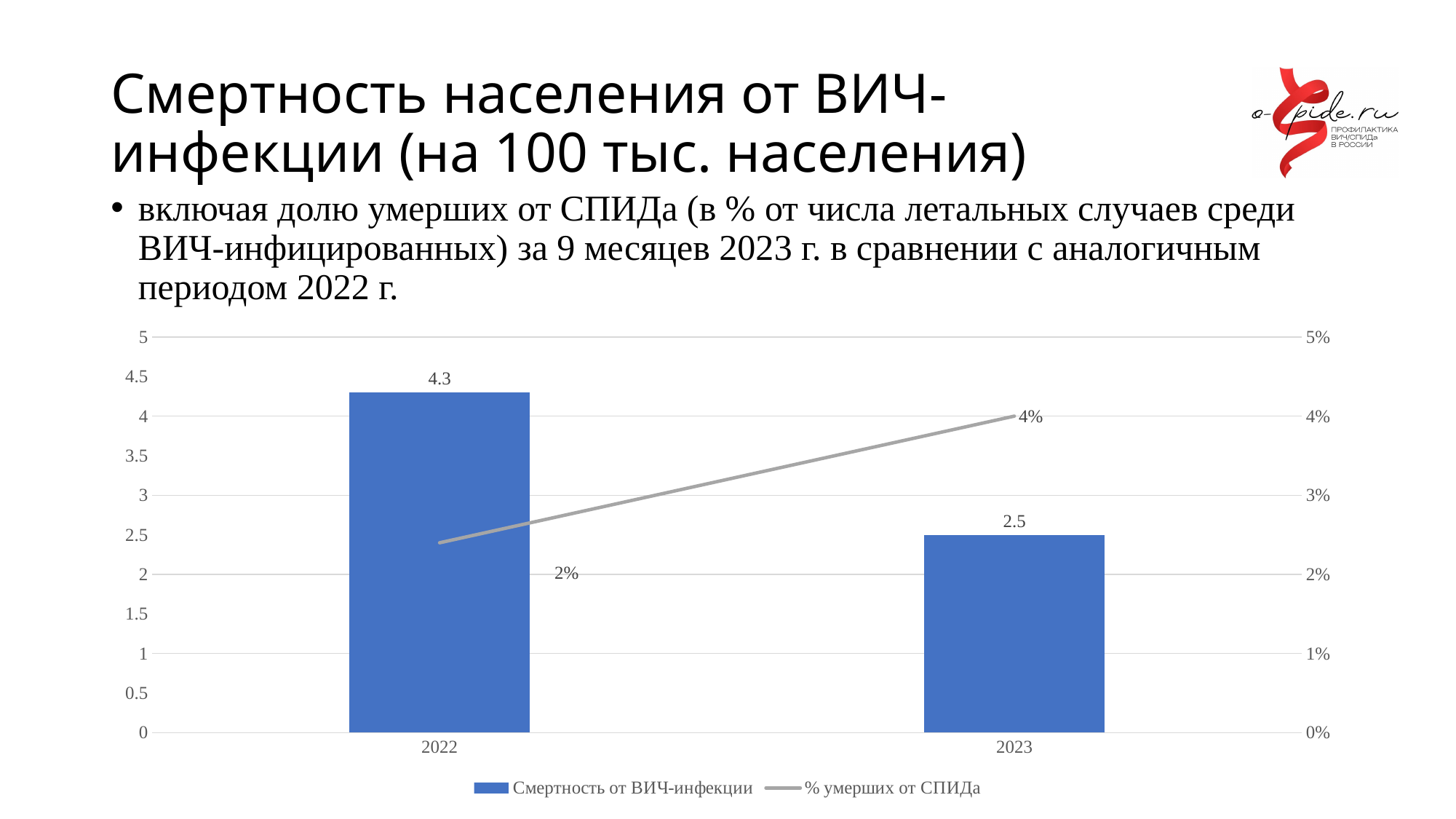
How many series does the legend list? 2 Does the Смертность от ВИЧ-инфекции series rise or fall from 2022 to 2023? fall What is the value of Смертность от ВИЧ-инфекции for 2023? 2.5 What is the value of % умерших от СПИДа for 2023? 4% What is the value of % умерших от СПИДа for 2022? 2% What is the value of Смертность от ВИЧ-инфекции for 2022? 4.3 How many years are shown on the x axis? 2 What is the difference between the Смертность от ВИЧ-инфекции values for 2022 and 2023? 1.8 Which year has the lower value of % умерших от СПИДа? 2022 Is the value of % умерших от СПИДа larger in 2022 or in 2023? 2023 Which year has the higher value of Смертность от ВИЧ-инфекции? 2022 Which series is drawn as a line rather than bars? % умерших от СПИДа